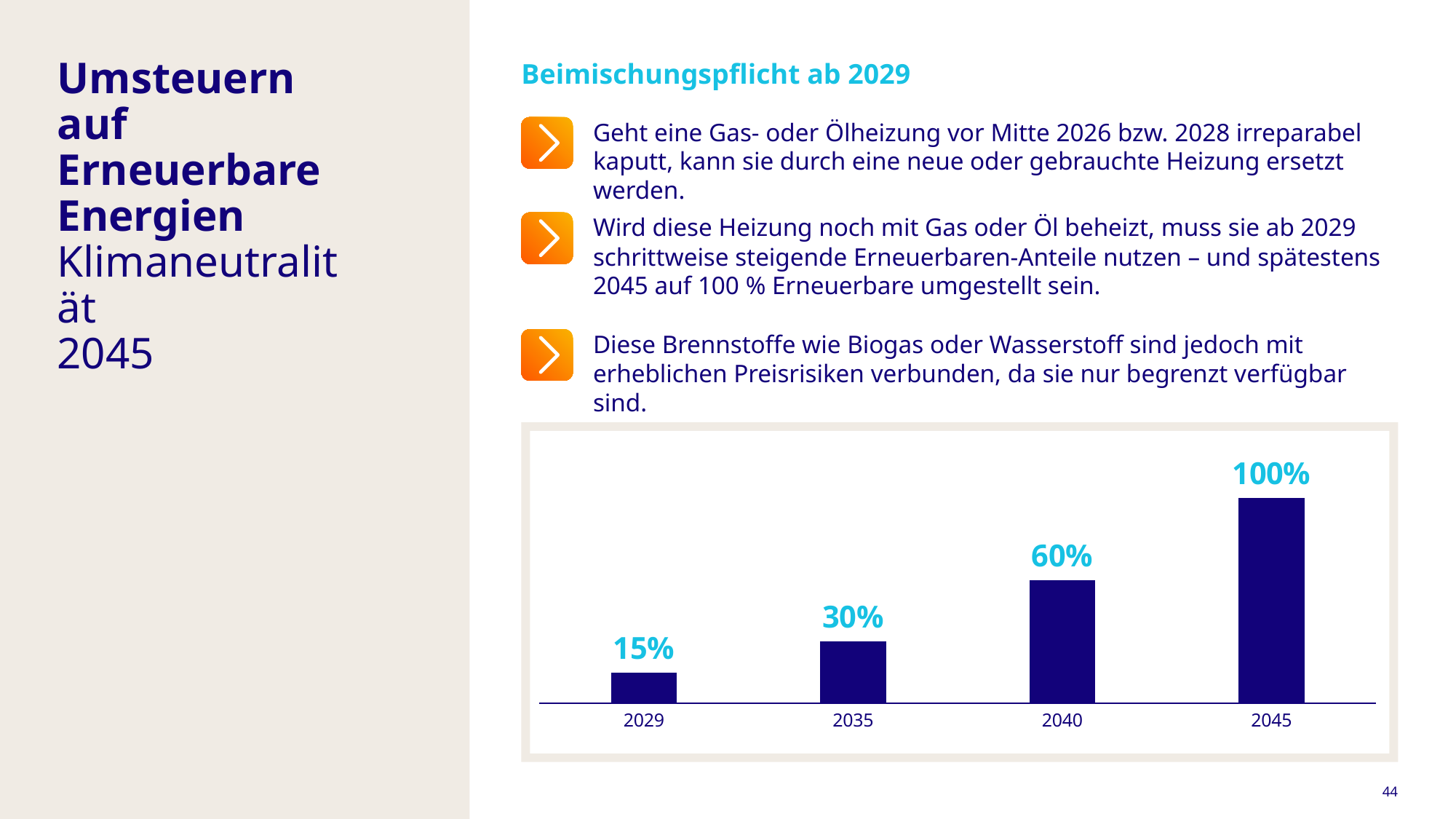
Which year has the lowest value? 2029 Which year has the highest value? 2045 What is the value shown for 2045? 100% What is the value shown for 2040? 60% Which is larger, the value for 2035 or the value for 2040? 2040 How many years are shown on the x axis? 4 What kind of chart is shown? Bar chart What is the difference between the values for 2045 and 2040? 40% Do the values rise or fall from 2029 to 2045? Rise What is the difference between the values for 2035 and 2029? 15% What is the value shown for 2029? 15% What is the value shown for 2035? 30%